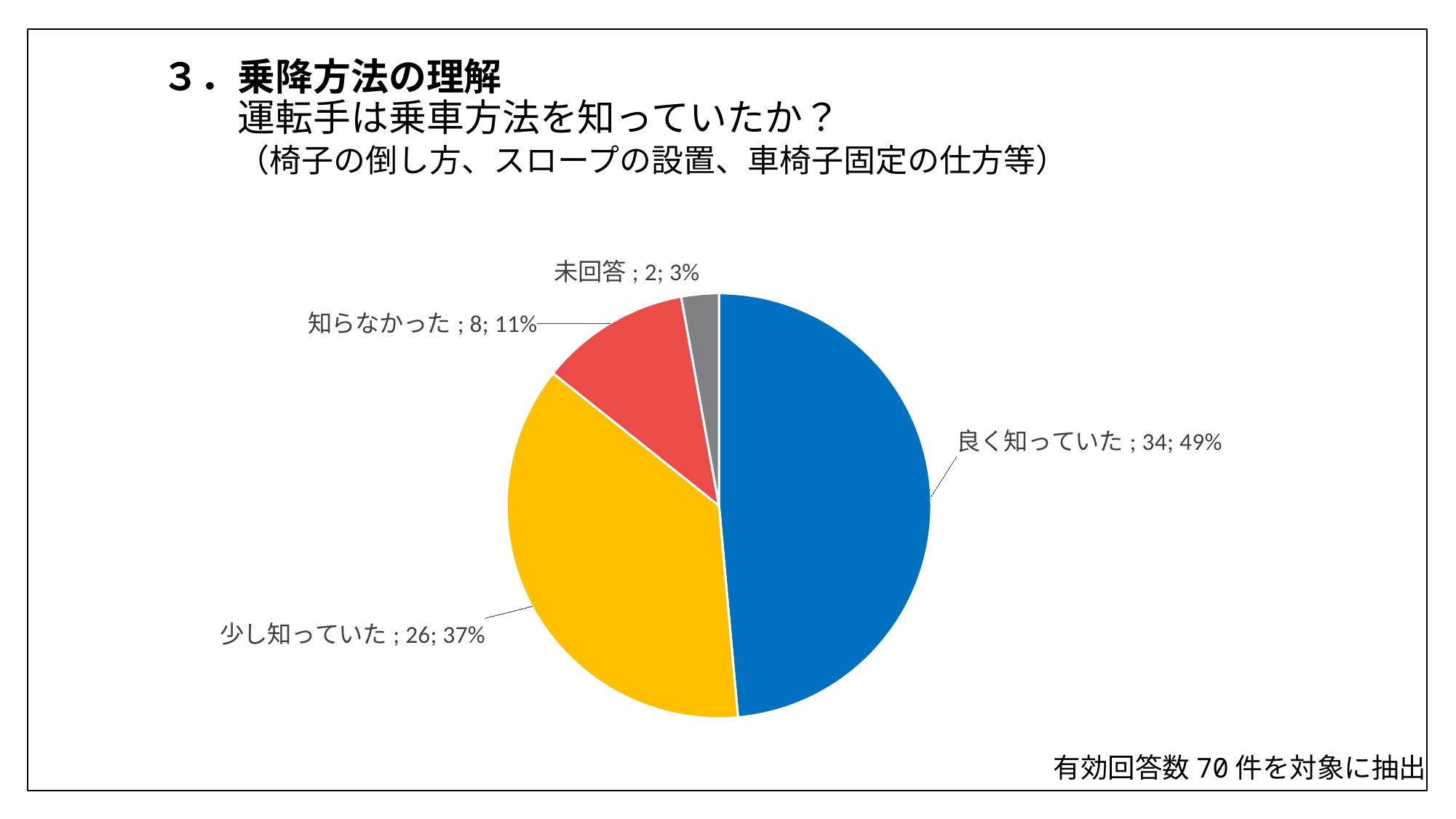
What is the total count across all slices? 70 How many slices does the pie chart have? 4 What percentage share does 未回答 have? 3% What percentage share does 少し知っていた have? 37% What kind of chart is shown on the slide? pie chart Which is larger, the count for 知らなかった or the count for 未回答? 知らなかった Which category has the largest slice? 良く知っていた Which category has the smallest slice? 未回答 What is the count for 良く知っていた? 34 What colour is the slice for 少し知っていた? yellow What is the count for 知らなかった? 8 What is the difference in count between 良く知っていた and 少し知っていた? 8